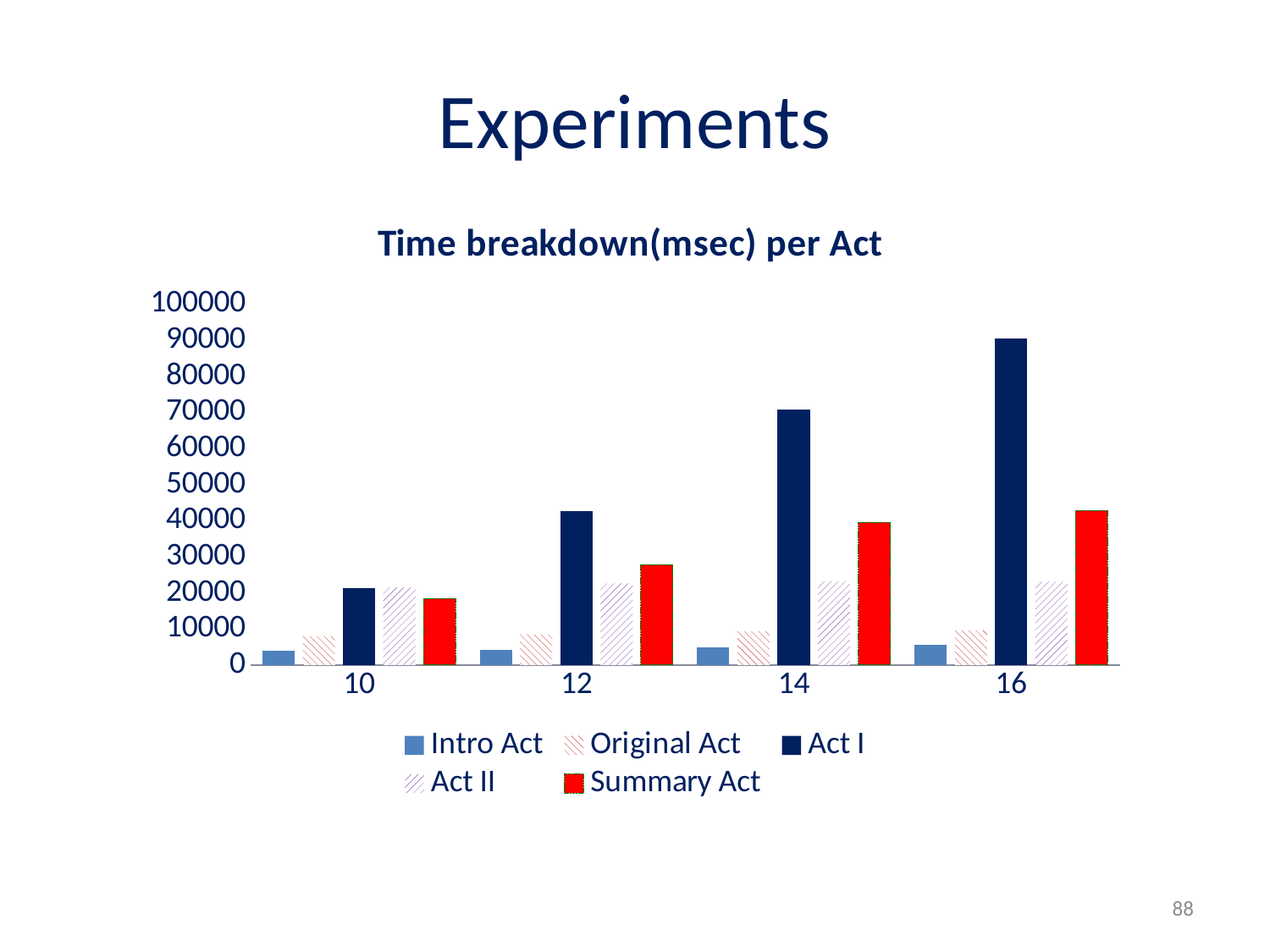
For which category is the Act I value lowest? 10 Is the Act I value for category 14 greater or less than 50000? greater Is the Summary Act value for category 12 greater or less than 20000? greater For which category is the Act I value highest? 16 How many categories are shown on the x axis? 4 What is the title of the chart? Time breakdown(msec) per Act What kind of chart is shown on the slide? bar chart Is the Intro Act value for category 10 greater or less than 10000? less For category 14, which is larger: the Act I value or the Summary Act value? Act I How many series does the legend list? 5 Do the Act I values rise or fall as the x axis goes from 10 to 16? rise